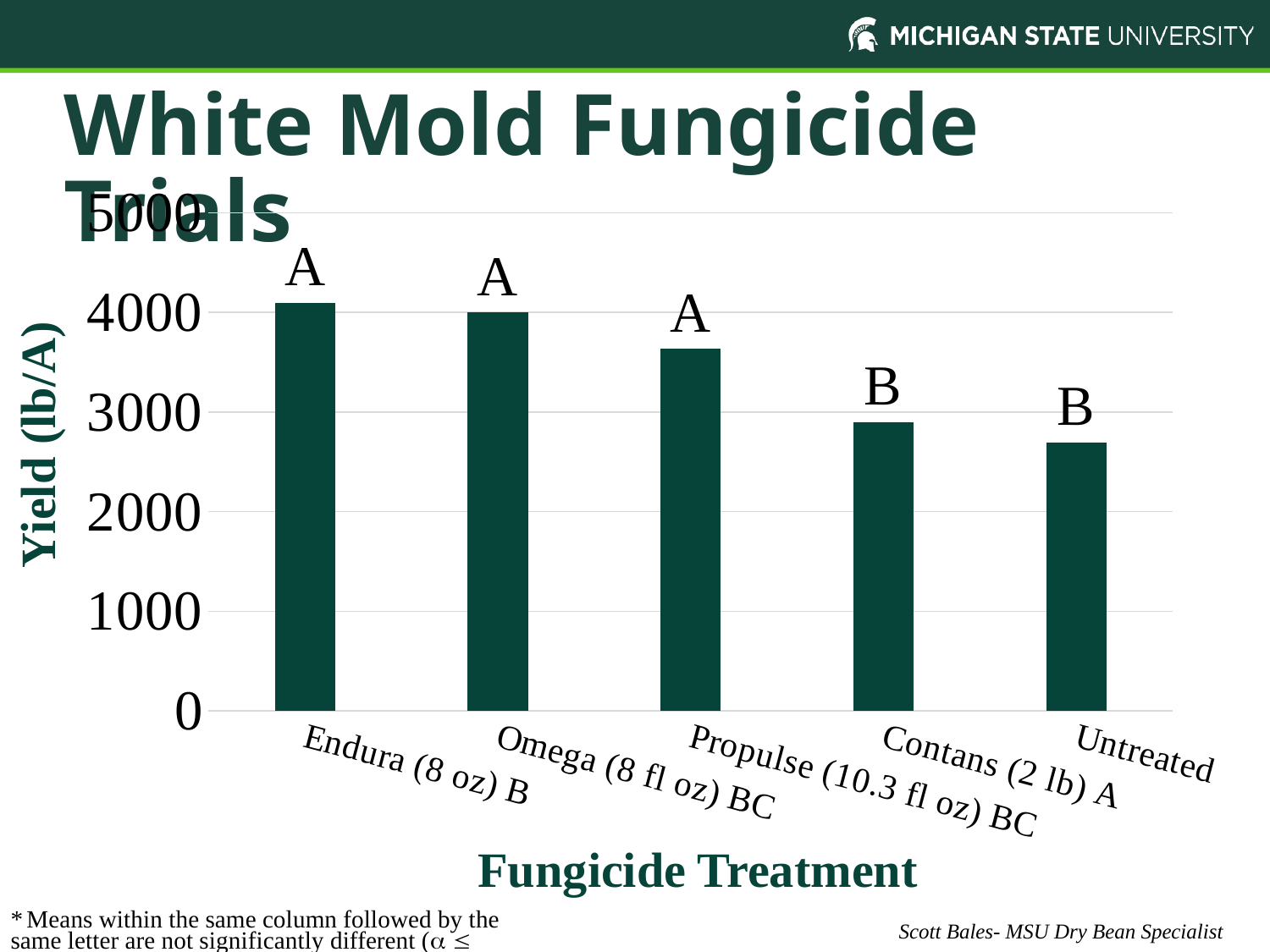
Is the yield for Untreated greater or less than 3000? less Which fungicide treatment has the lowest yield? Untreated Which has the higher yield, Propulse (10.3 fl oz) BC or Contans (2 lb) A? Propulse (10.3 fl oz) BC Which has the higher yield, Omega (8 fl oz) BC or Propulse (10.3 fl oz) BC? Omega (8 fl oz) BC How many fungicide treatments are plotted on the chart? 5 Is the yield for Endura (8 oz) B greater or less than 3000? greater Is the yield for Propulse (10.3 fl oz) BC greater or less than 4000? less What letter label is printed above the bar for Contans (2 lb) A? B What is the title of the vertical axis? Yield (lb/A) What kind of chart is shown on the slide? bar chart Do the yield values rise or fall moving from left to right across the treatments? fall